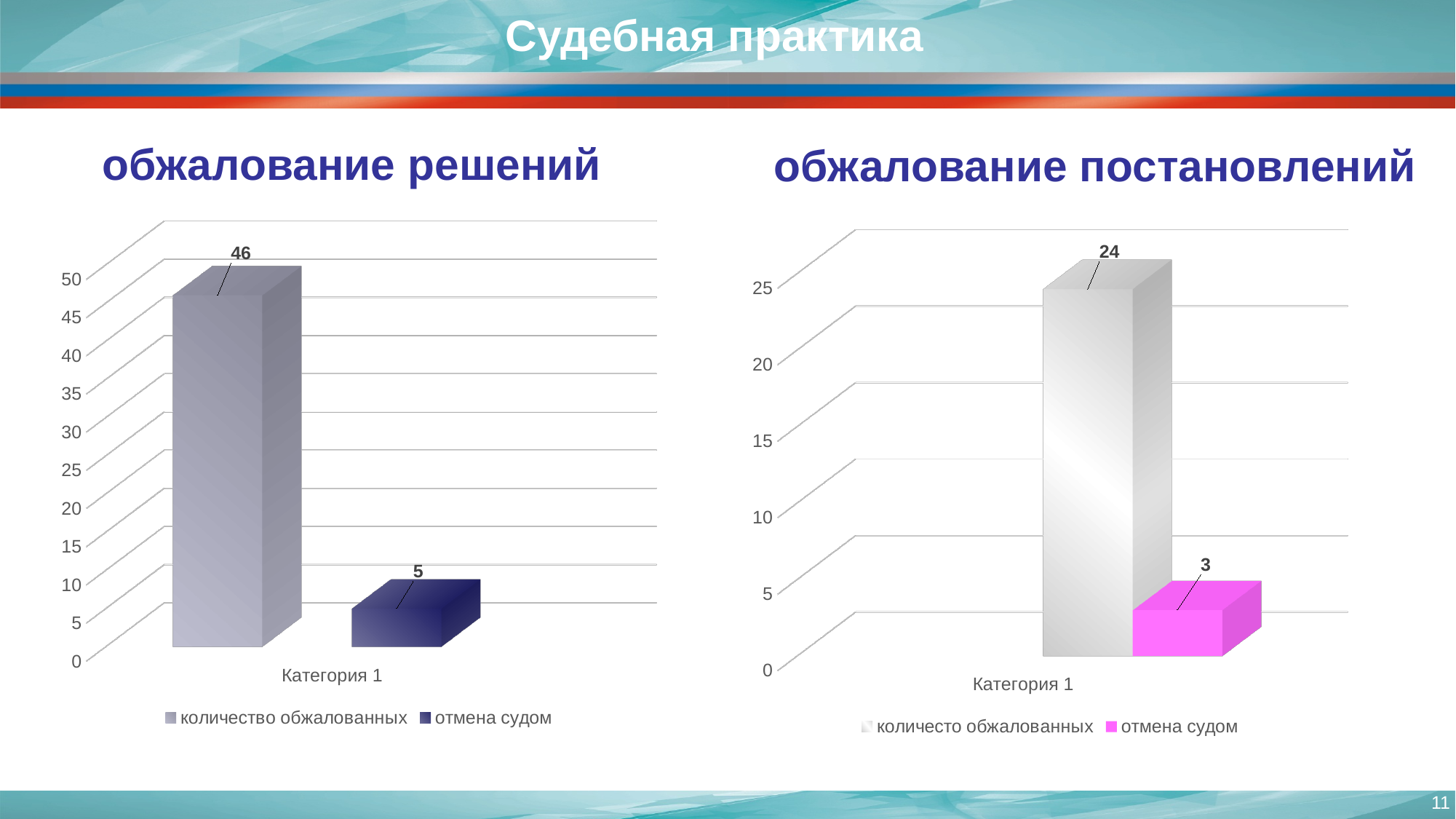
In the 'обжалование решений' chart, what is the value for 'отмена судом'? 5 In the 'обжалование постановлений' chart, what is the value for 'количесто обжалованных'? 24 In the 'обжалование постановлений' chart, which series has the lower value? отмена судом In the 'обжалование постановлений' chart, what is the value for 'отмена судом'? 3 What kind of chart is the 'обжалование постановлений' chart? bar chart In the 'обжалование решений' chart, which series has the higher value? количество обжалованных What is the category label on the x axis of the 'обжалование решений' chart? Категория 1 How many series does the legend of the 'обжалование решений' chart list? 2 In the 'обжалование решений' chart, what is the difference between 'количество обжалованных' and 'отмена судом'? 41 In the 'обжалование решений' chart, what is the value for 'количество обжалованных'? 46 In the 'обжалование постановлений' chart, what is the difference between 'количесто обжалованных' and 'отмена судом'? 21 Which is larger: 'отмена судом' in the 'обжалование решений' chart or 'отмена судом' in the 'обжалование постановлений' chart? обжалование решений